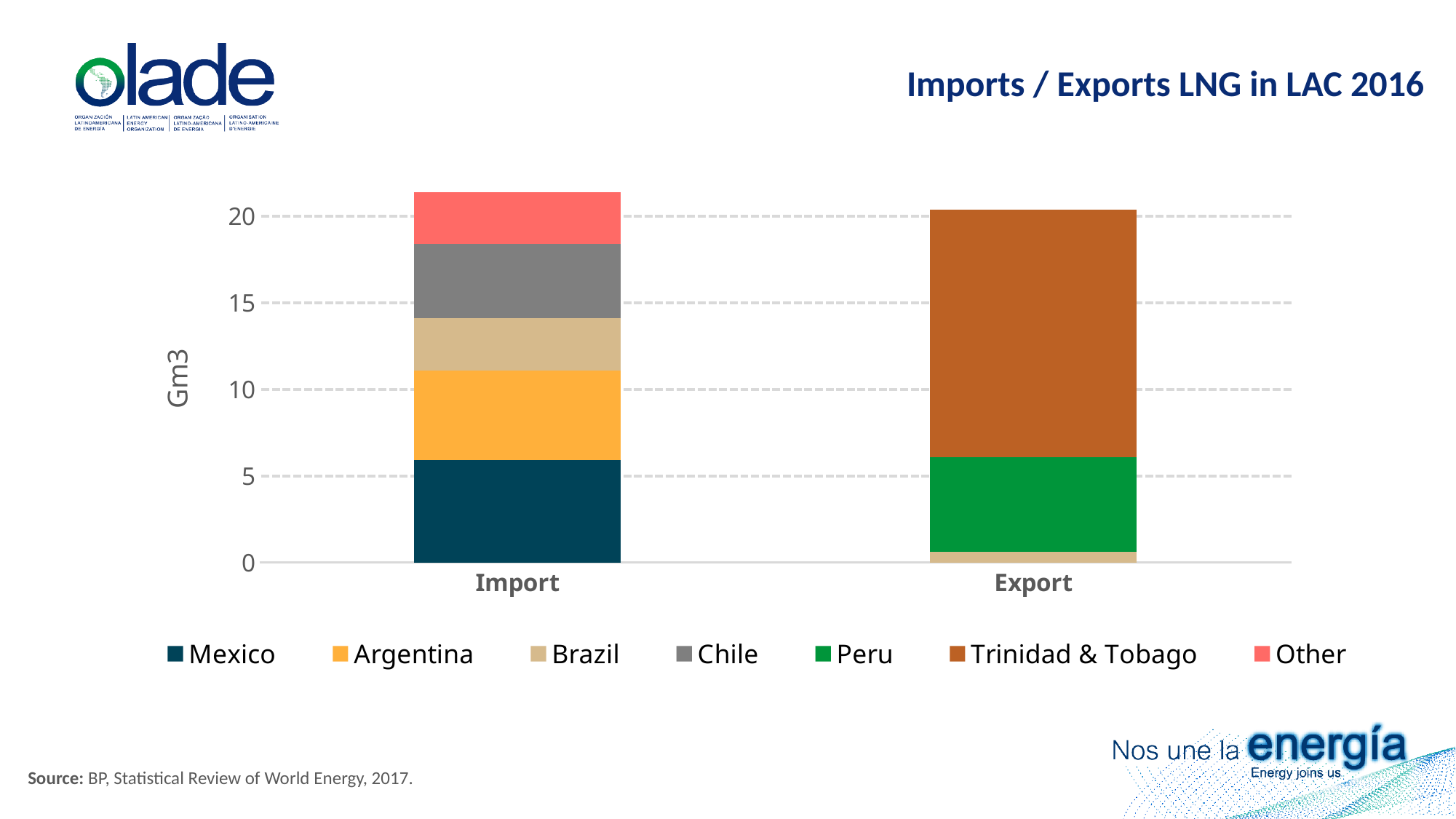
Is the total height of the Export bar greater or less than 15? greater What is the title of the chart? Imports / Exports LNG in LAC 2016 Is the total height of the Import bar greater or less than 20? greater Which series appears in the Export bar but not in the Import bar: Peru or Argentina? Peru Is the Mexico segment of the Import bar greater or less than 5? greater Which country accounts for the smallest segment of the Export bar? Brazil How many series does the chart legend list? 7 What kind of chart is shown on the slide? Stacked bar chart Which country accounts for the largest segment of the Export bar? Trinidad & Tobago How many categories are shown on the x axis of the chart? 2 Which country accounts for the largest segment of the Import bar? Mexico What unit is shown on the vertical axis of the chart? Gm3